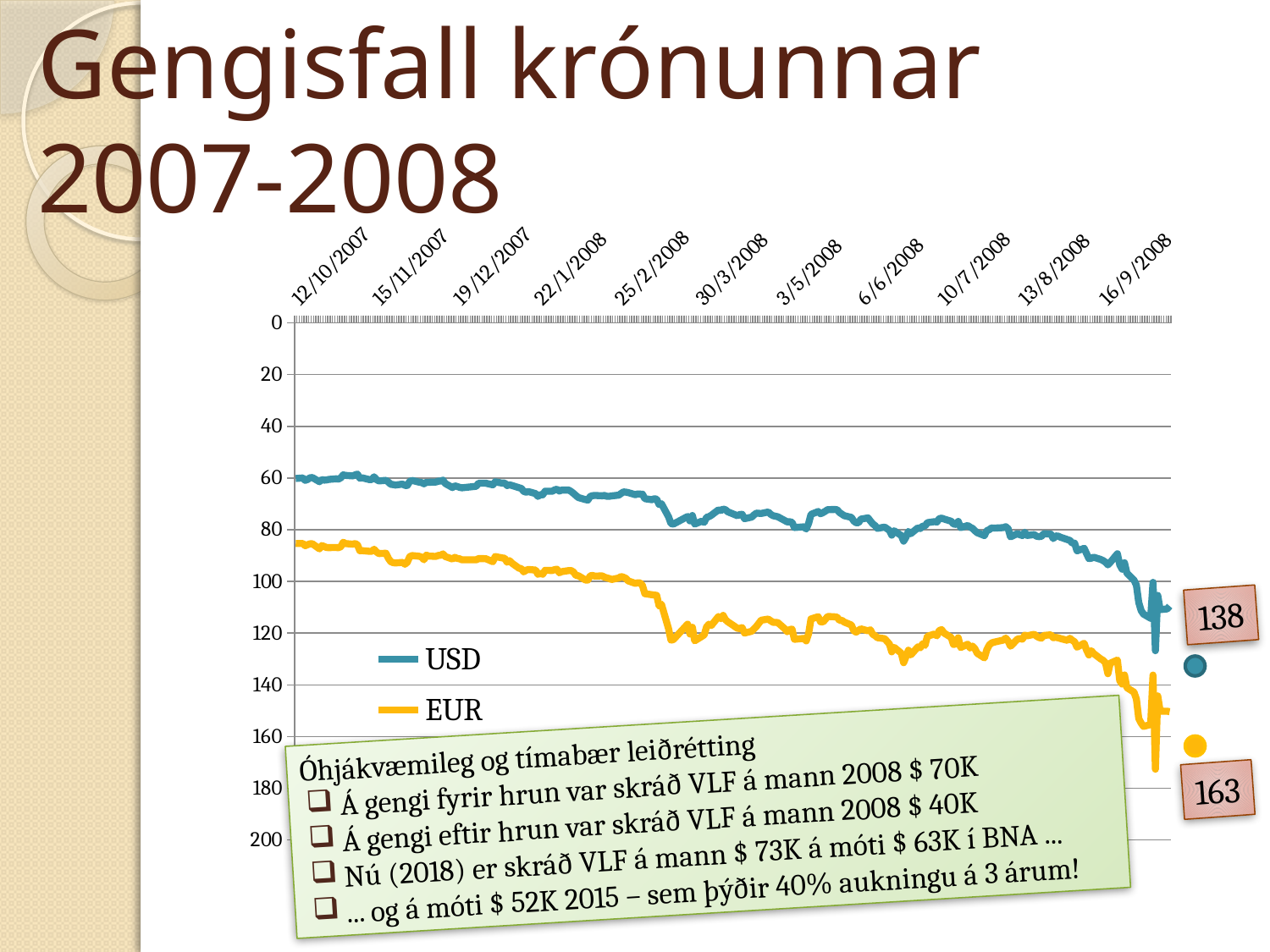
Is the USD value at 16/9/2008 greater or less than 100? less What kind of chart is shown on the slide? line chart Which series has the higher value at 12/10/2007, USD or EUR? EUR Reading the y-axis values, do the EUR values increase or decrease from 12/10/2007 to 16/9/2008? increase Is the EUR value at 12/10/2007 greater or less than 100? less How many series does the chart legend list? 2 What is the first date label on the x axis of the chart? 12/10/2007 Is the USD value at 12/10/2007 greater or less than 80? less What are the two series named in the chart legend? USD and EUR How many date labels are shown along the x axis of the chart? 11 Which series has the higher value at 16/9/2008, USD or EUR? EUR